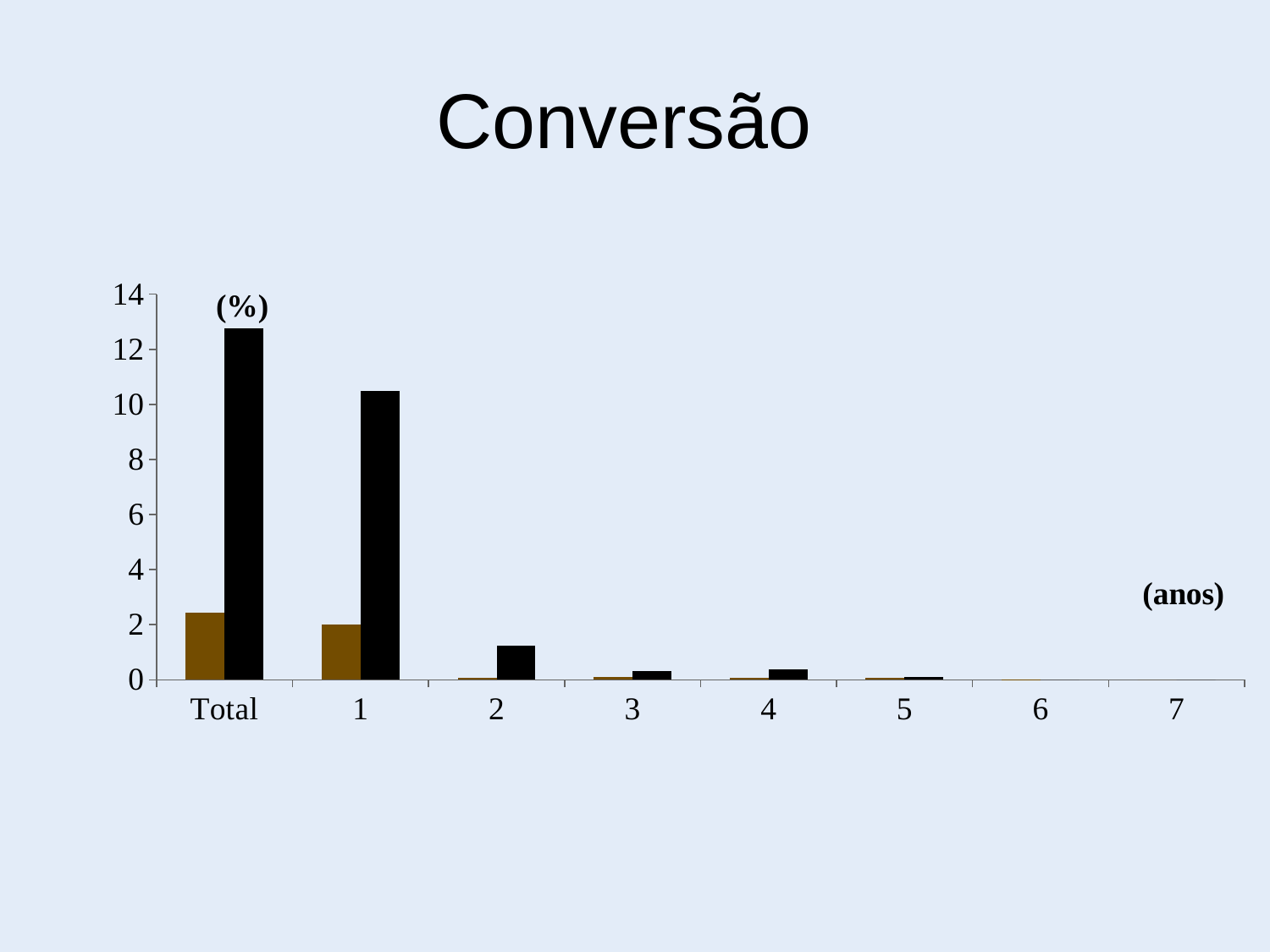
What unit is indicated for the vertical axis of the chart? (%) How many categories are shown on the x axis of the chart? 8 For the Total category, which bar is taller, the brown one or the black one? the black one Is the black bar for category 1 greater or less than 10? greater What is the title of the slide? Conversão Which category has the tallest black bar? Total Is the black bar for category 2 greater or less than 2? less Is the black bar for Total greater or less than 12? greater Which black bar is taller, the one for Total or the one for category 1? Total Do the black bars generally rise or fall from category 1 to category 7? fall What kind of chart is shown on the slide? bar chart